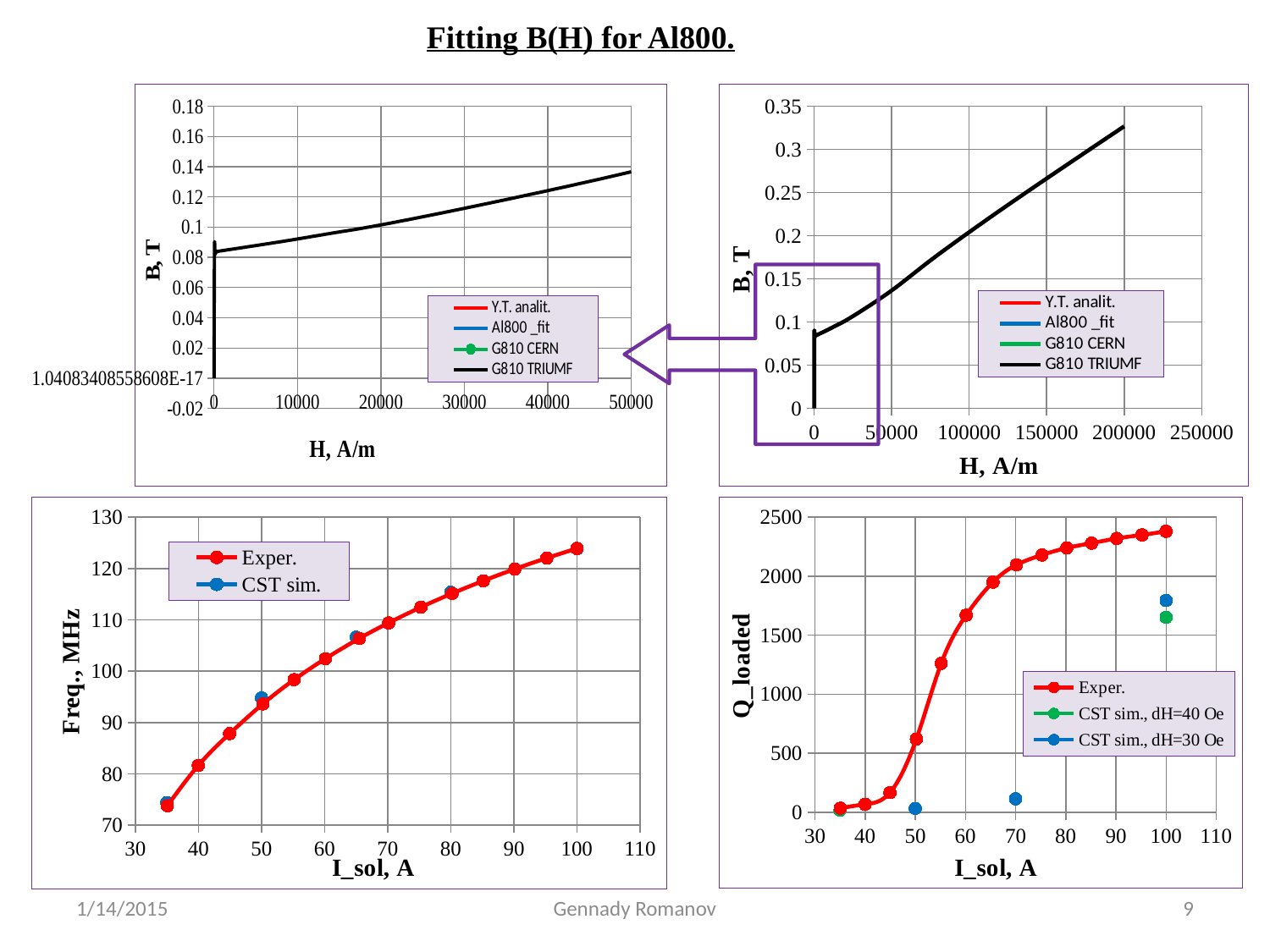
In the bottom-right chart (Q_loaded vs I_sol, A), how many series does the legend list? 3 In the bottom-right chart, is the CST sim., dH=40 Oe value at I_sol = 100 A greater or less than 2000? less What is the x-axis label of the bottom-right chart (Q_loaded)? I_sol, A In the top-right chart (H axis up to 250000), is the B value at H = 200000 A/m greater or less than 0.3 T? greater In the bottom-right chart, is the Exper. Q_loaded value at I_sol = 100 A greater or less than 2000? greater In the bottom-right chart, at I_sol = 100 A, which series has the larger value: CST sim., dH=40 Oe or CST sim., dH=30 Oe? CST sim., dH=30 Oe In the bottom-left chart (Freq., MHz vs I_sol, A), how many series does the legend list? 2 What kind of chart is the bottom-left chart (Freq., MHz vs I_sol, A)? line chart In the bottom-left chart, does the Exper. frequency rise or fall as I_sol increases from 35 A to 100 A? rise In the top-right chart (B, T vs H, A/m up to 250000), how many series does the legend list? 4